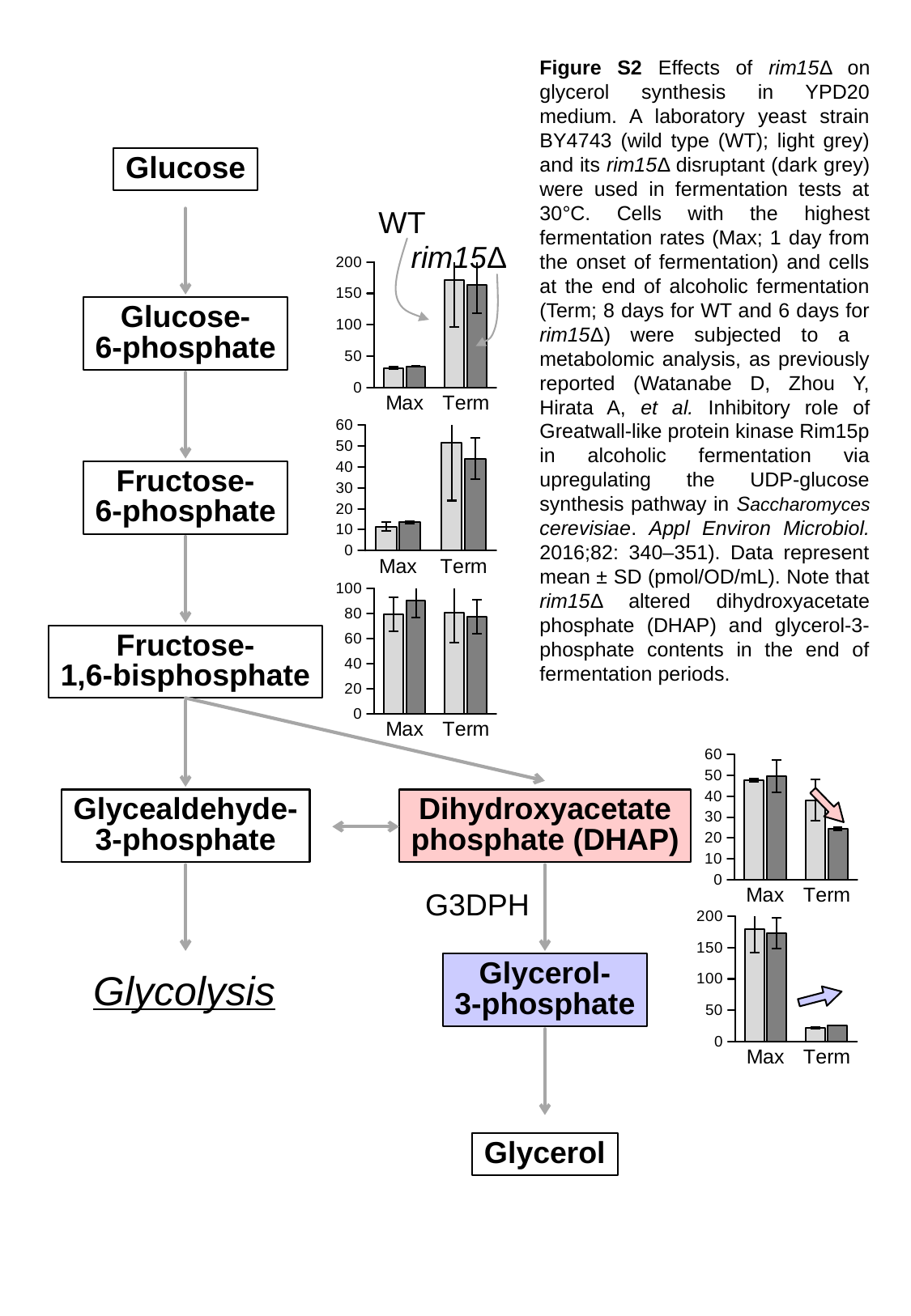
In the chart next to the Dihydroxyacetate phosphate (DHAP) box, which is larger at Term, the WT bar or the rim15Δ bar? WT In the chart next to the Fructose-1,6-bisphosphate box, is the rim15Δ value for Max greater or less than 60? greater How many categories are on the x axis of the chart next to the Glycerol-3-phosphate box? 2 What kind of chart is shown next to the Glucose-6-phosphate box? bar chart In the chart next to the Glycerol-3-phosphate box, do the values rise or fall from Max to Term? fall In the chart next to the Dihydroxyacetate phosphate (DHAP) box, is the rim15Δ value for Term greater or less than 30? less In the chart next to the Glucose-6-phosphate box, is the WT value for Term greater or less than 100? greater How many series are labelled in the chart next to the Glucose-6-phosphate box? 2 Which series is shown in dark grey in the bar charts? rim15Δ